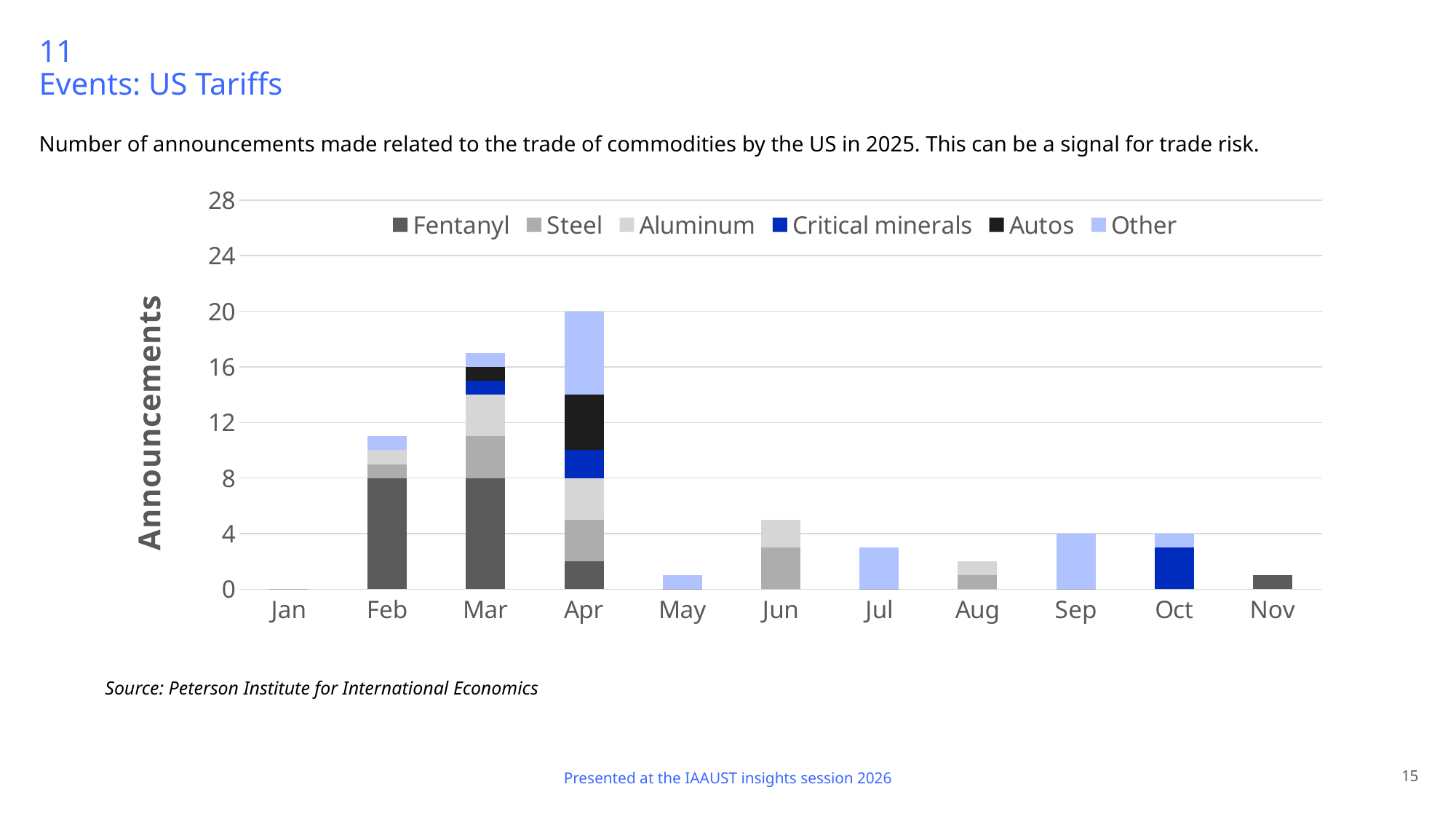
How many months are shown on the x axis? 11 What is the total number of announcements in Sep? 4 Which month has more announcements in total, Feb or Mar? Mar Which month has the highest total number of announcements? Apr Is the total number of announcements in Feb greater or less than 8? greater Is the total number of announcements in Jul greater or less than 4? less What kind of chart is shown on the slide? Stacked bar chart How many series does the legend list? 6 Which month has the lowest total number of announcements? Jan What is the label on the y axis? Announcements What is the total number of announcements in Apr? 20 Do total announcements rise or fall from Apr to May? Fall